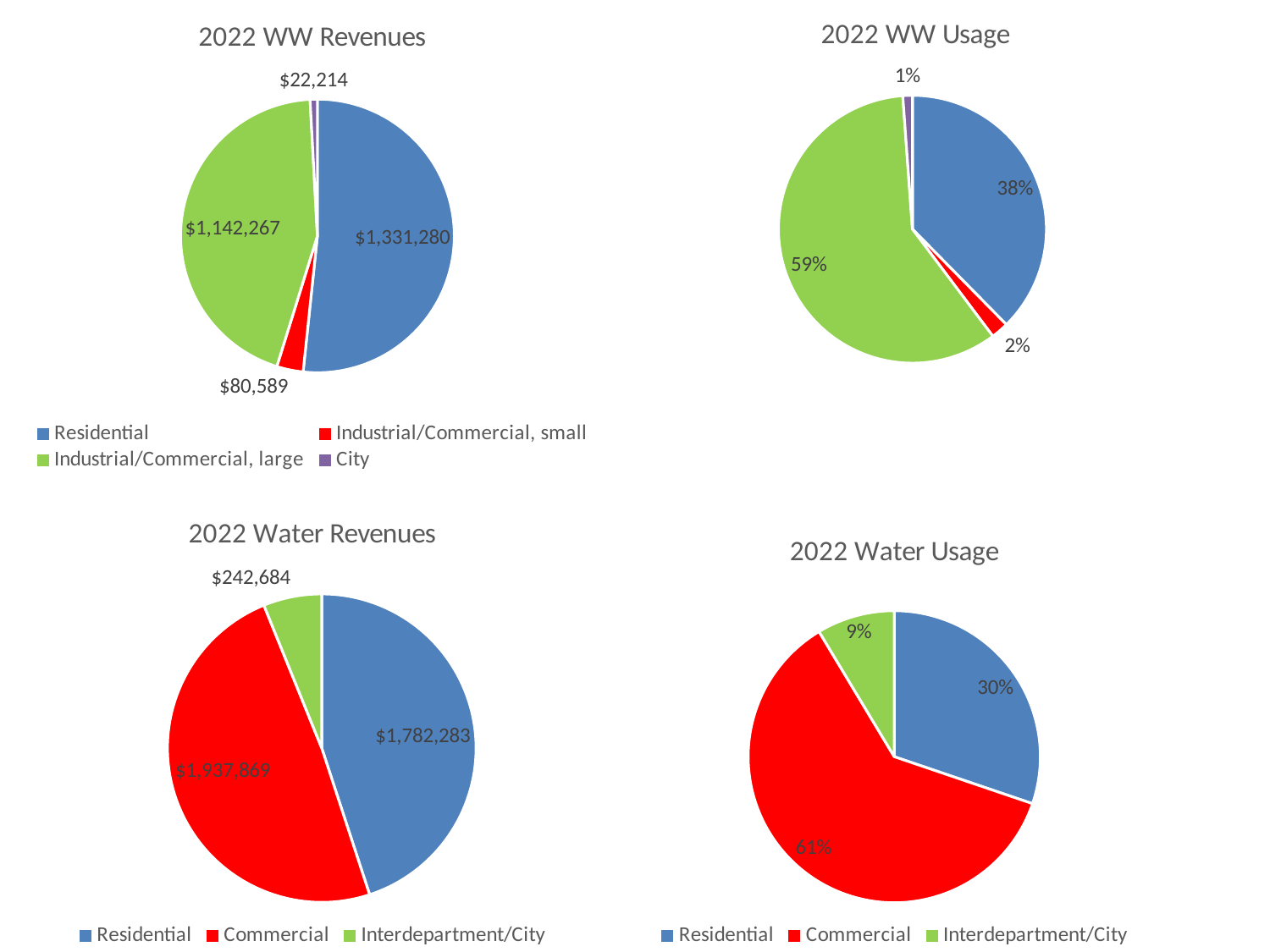
In the 2022 Water Revenues chart, what is the difference between the Commercial and Residential revenues? $155,586 In the 2022 WW Revenues chart, which category has the highest revenue? Residential In the 2022 Water Usage chart, what percentage of usage is Commercial? 61% How many slices does the 2022 Water Usage chart have? 3 How many entries does the legend of the 2022 WW Revenues chart list? 4 In the 2022 Water Revenues chart, what is the revenue for Commercial? $1,937,869 In the 2022 WW Revenues chart, which category has the lowest revenue? City In the 2022 WW Usage chart, what percentage is shown for the largest slice? 59% In the 2022 Water Revenues chart, which is larger, Commercial or Residential revenue? Commercial In the 2022 WW Revenues chart, what is the revenue for Residential? $1,331,280 In the 2022 WW Revenues chart, what is the difference between the Residential and Industrial/Commercial, large revenues? $189,013 In the 2022 WW Revenues chart, what is the revenue for Industrial/Commercial, large? $1,142,267